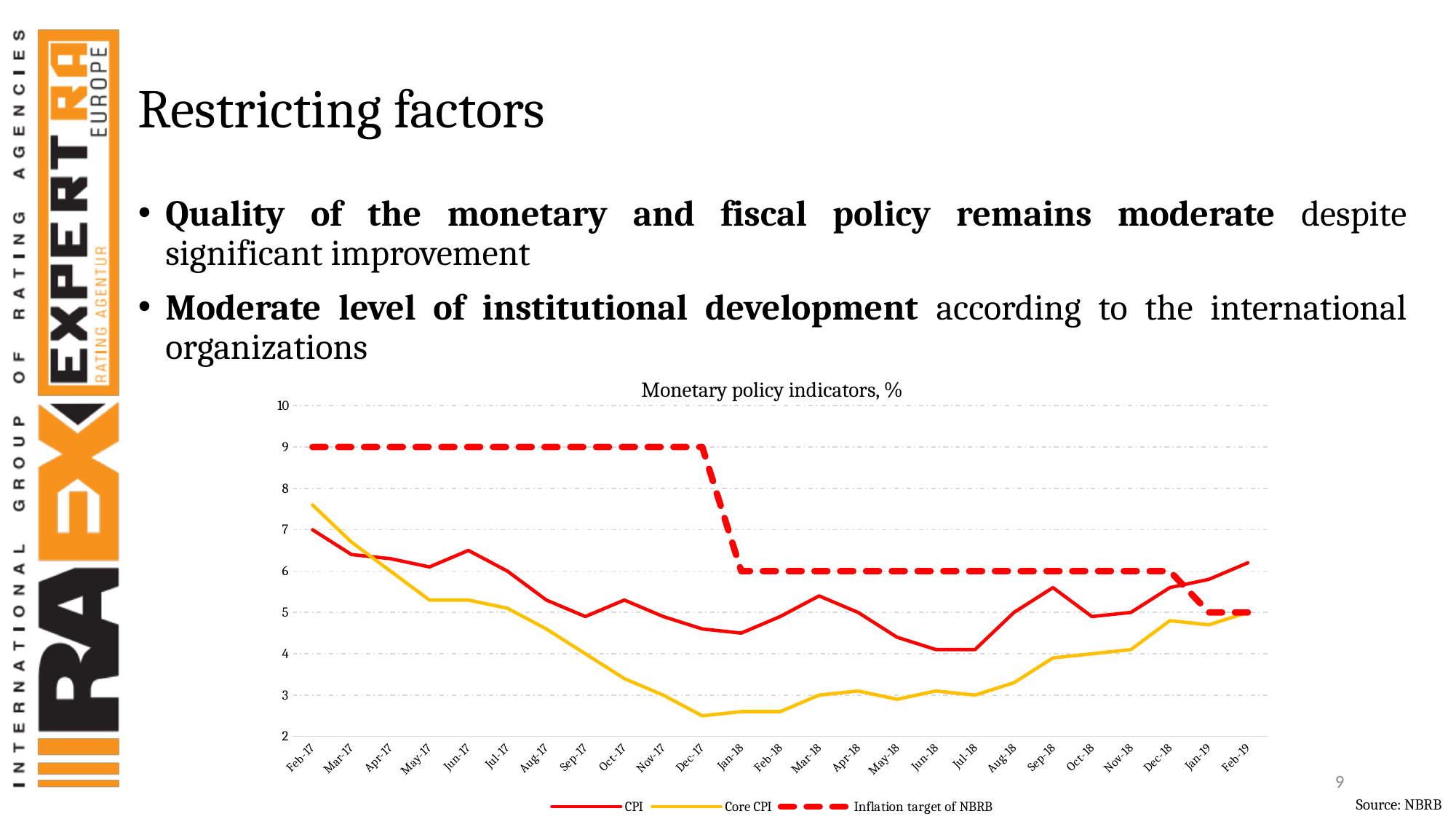
Is the Core CPI value for Dec-17 greater or less than 3? less What is the value of the Inflation target of NBRB in Feb-17? 9 What is the value of the Inflation target of NBRB in Jun-18? 6 What is the value of the Inflation target of NBRB in Feb-19? 5 How many series does the legend of the chart list? 3 What is the title of the chart? Monetary policy indicators, % What kind of chart is shown on the slide? line chart In which month is Core CPI at its lowest? Dec-17 Which is larger in Dec-17, CPI or Core CPI? CPI Is the CPI value for Jun-18 greater or less than 5? less How many months are shown on the x axis of the chart? 25 Is the Core CPI value for Feb-17 greater or less than 7? greater